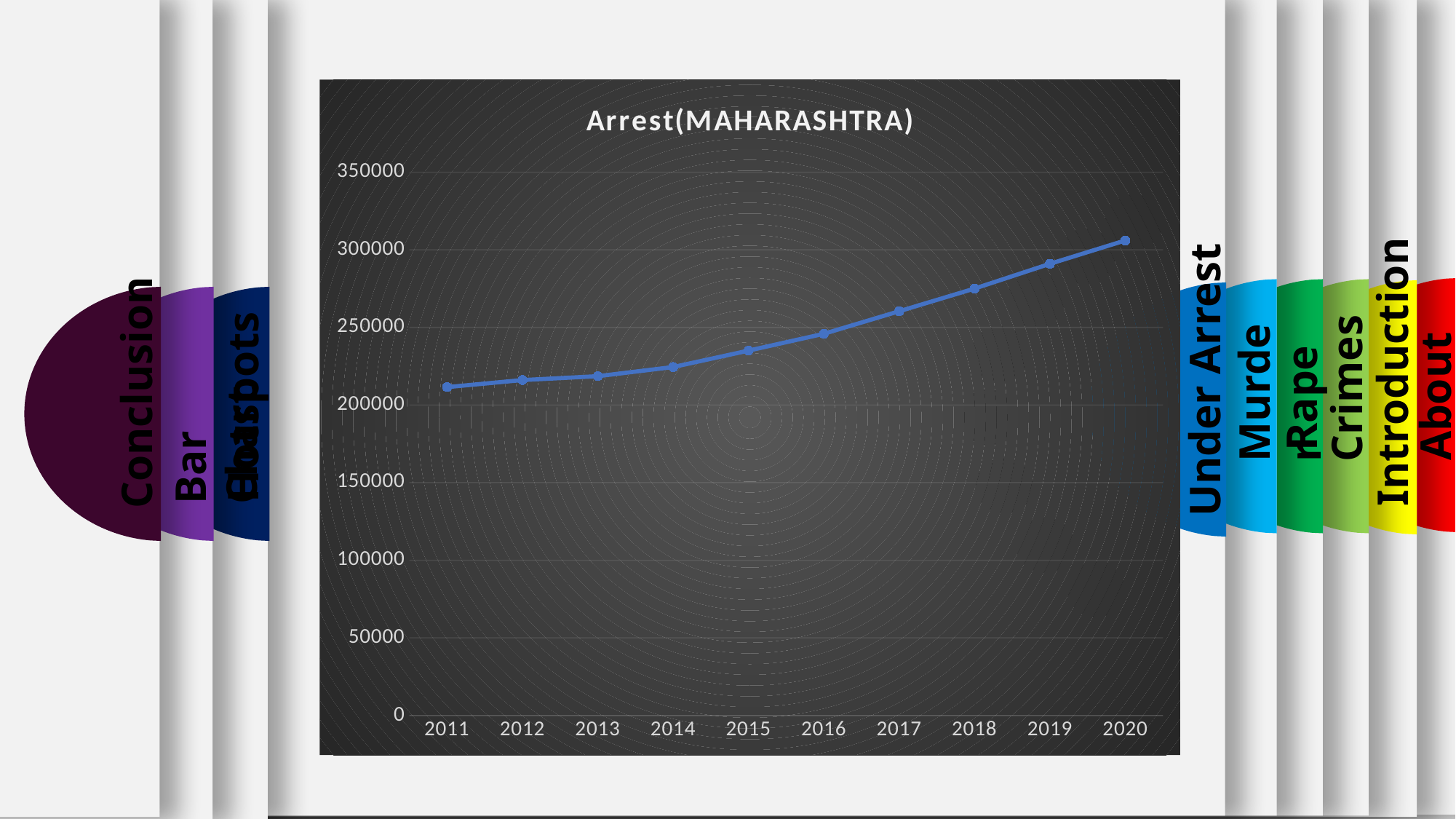
What is the title of the chart? Arrest(MAHARASHTRA) Which year has the lowest value in the chart? 2011 What kind of chart is shown on the slide? Line chart Which is larger, the value for 2019 or the value for 2013? 2019 Which year has the highest value in the chart? 2020 What is the first year shown on the x axis of the chart? 2011 Is the value for 2011 greater or less than 250000? less Do the values in the chart rise or fall from 2011 to 2020? Rise Is the value for 2014 greater or less than 250000? less Is the value for 2020 greater or less than 300000? greater How many years are plotted along the x axis of the chart? 10